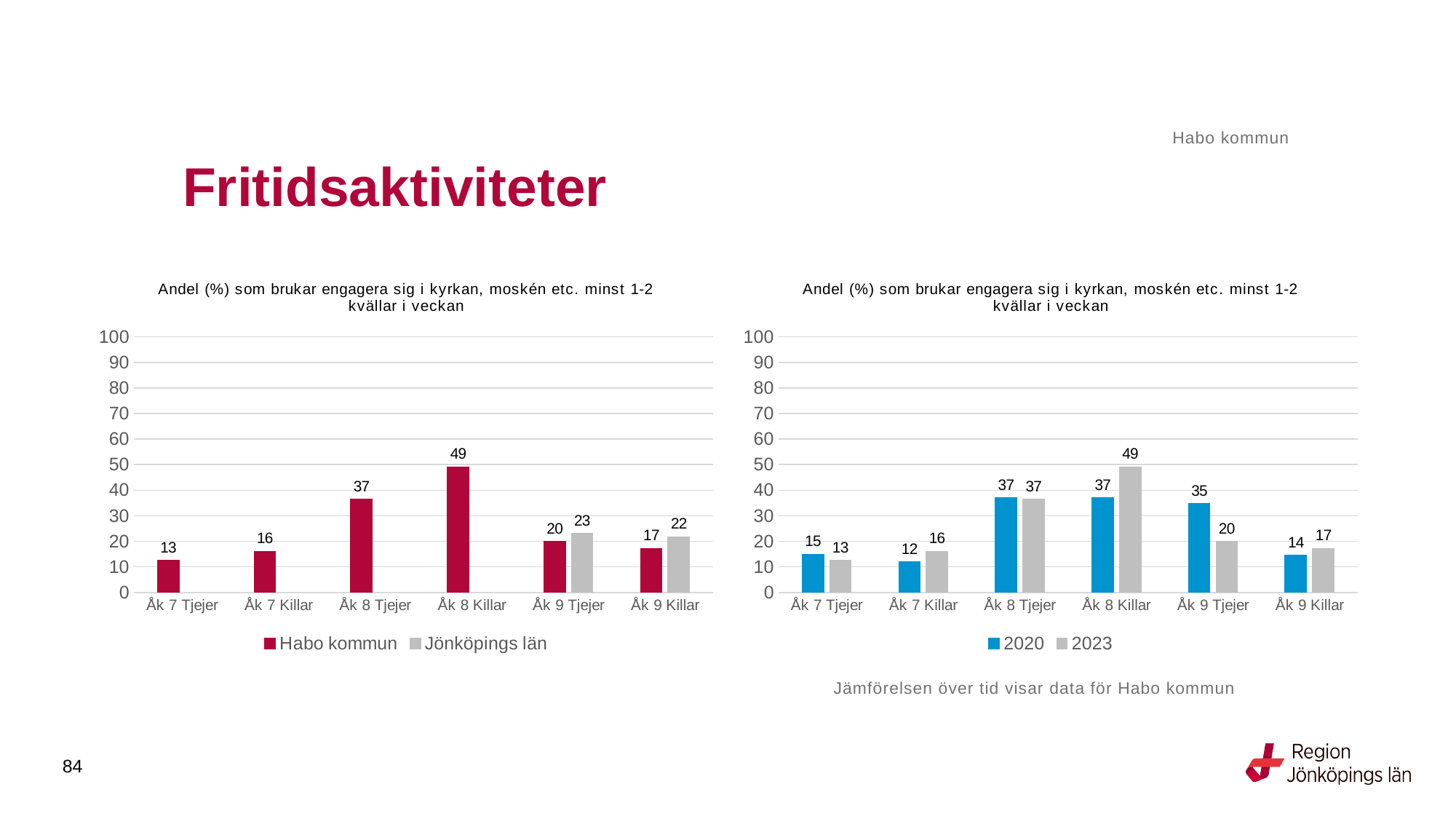
In the right chart, how many categories are shown on the x axis? 6 In the left chart, what is the value for Jönköpings län for Åk 9 Tjejer? 23 In the left chart, what is the difference between Jönköpings län and Habo kommun for Åk 9 Killar? 5 In the right chart, what is the 2020 value for Åk 9 Tjejer? 35 In the left chart, which category has the lowest Habo kommun value? Åk 7 Tjejer In the right chart, what is the difference between the 2020 and 2023 values for Åk 9 Tjejer? 15 In the left chart, which category has the highest Habo kommun value? Åk 8 Killar In the left chart, how many series does the legend list? 2 In the right chart, what is the 2023 value for Åk 7 Killar? 16 What kind of chart is the right chart? Bar chart In the left chart, what is the value for Habo kommun for Åk 8 Killar? 49 In the right chart, which is larger for Åk 8 Killar, the 2020 value or the 2023 value? 2023